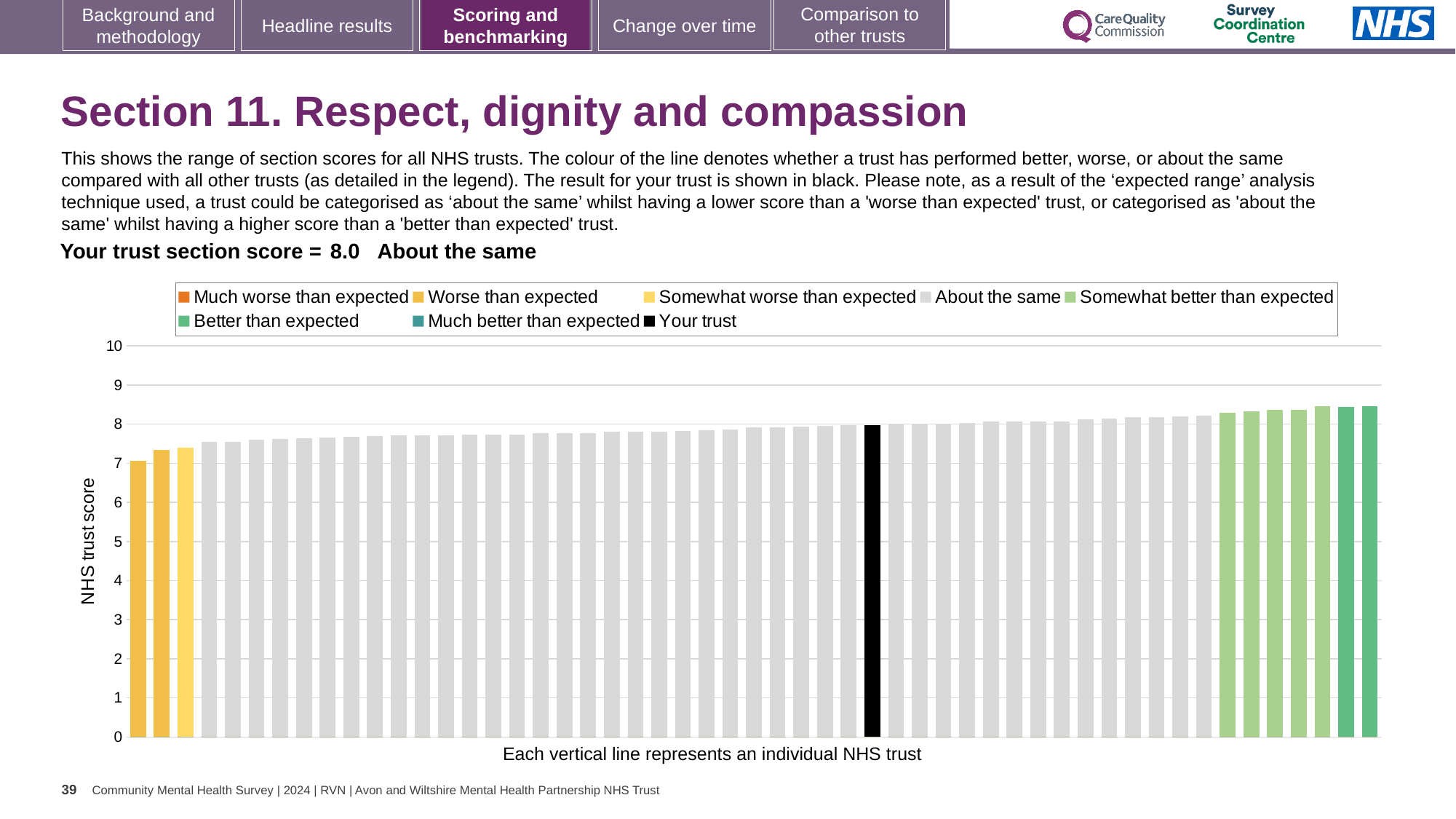
Do the bar values rise or fall from left to right along the x axis? rise What is the section score for your trust shown on the slide? 8.0 Which performance category is your trust placed in for this section? About the same How many entries does the chart legend list? 8 Is the value of the rightmost (highest) bar greater or less than 9? less Is the value of the black 'Your trust' bar greater or less than 5? greater Is the value of the leftmost (lowest) bar greater or less than 6? greater How many bars on the chart are coloured black? 1 What is the label on the vertical axis of the chart? NHS trust score What colour is used for the 'Your trust' bar according to the legend? black What kind of chart is shown on the slide? bar chart